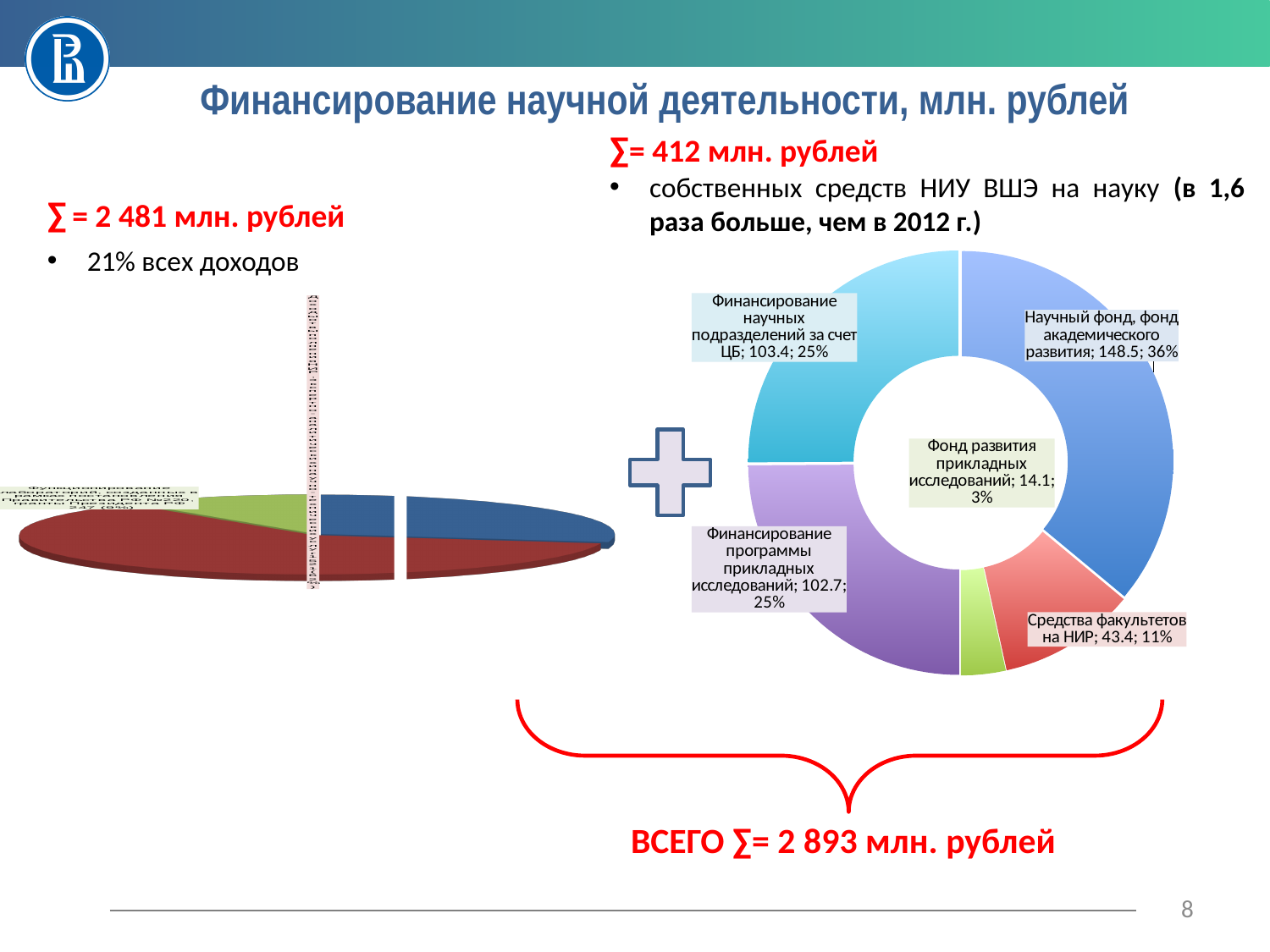
In the doughnut chart on the right, what is the value for 'Финансирование программы прикладных исследований'? 102.7 In the doughnut chart on the right, what share does 'Фонд развития прикладных исследований' have? 3% In the doughnut chart on the right, what is the value for 'Средства факультетов на НИР'? 43.4 In the doughnut chart on the right, what is the value for 'Финансирование научных подразделений за счет ЦБ'? 103.4 What kind of chart is on the right side of the slide? Doughnut chart How many categories are shown in the doughnut chart on the right? 5 In the doughnut chart on the right, which category has the smallest value? Фонд развития прикладных исследований In the doughnut chart on the right, what is the difference between 'Научный фонд, фонд академического развития' and 'Средства факультетов на НИР'? 105.1 What kind of chart is on the left side of the slide? Pie chart In the doughnut chart on the right, which category has the largest value? Научный фонд, фонд академического развития In the doughnut chart on the right, what is the value for 'Научный фонд, фонд академического развития'? 148.5 In the doughnut chart on the right, what share does 'Научный фонд, фонд академического развития' have? 36%